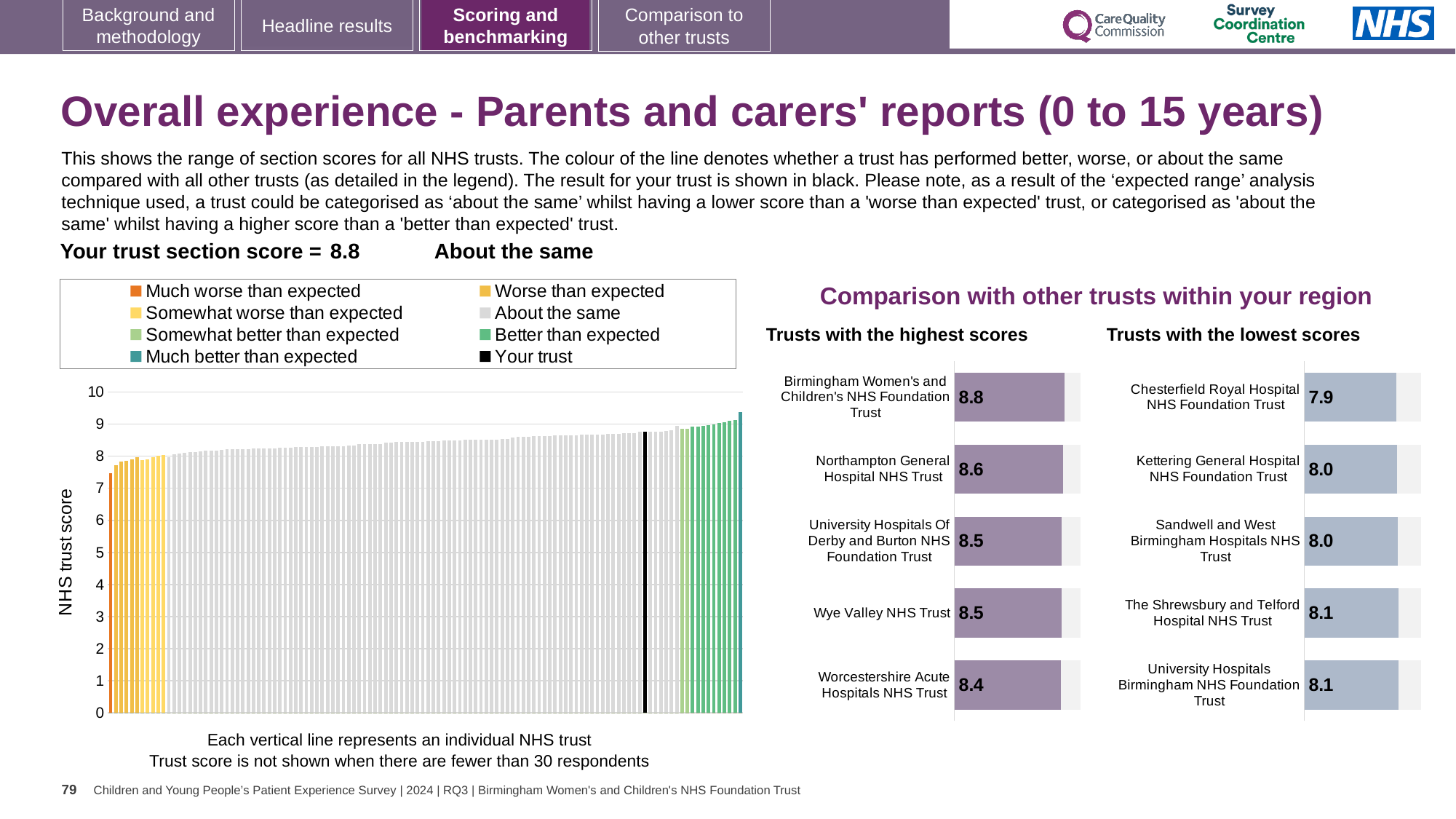
In the 'Trusts with the highest scores' chart, what is the score for Northampton General Hospital NHS Trust? 8.6 In the 'Trusts with the highest scores' chart, which trust has the highest score? Birmingham Women's and Children's NHS Foundation Trust In the main chart on the left showing all NHS trusts, is the value for the lowest (orange) bar greater or less than 8? less In the 'Trusts with the highest scores' chart, what is the difference between the scores of Birmingham Women's and Children's NHS Foundation Trust and Worcestershire Acute Hospitals NHS Trust? 0.4 In the 'Trusts with the highest scores' chart, what is the score for Worcestershire Acute Hospitals NHS Trust? 8.4 In the 'Trusts with the lowest scores' chart, what is the score for The Shrewsbury and Telford Hospital NHS Trust? 8.1 What kind of chart is the main chart on the left showing all NHS trusts? bar chart In the 'Trusts with the lowest scores' chart, what is the score for Chesterfield Royal Hospital NHS Foundation Trust? 7.9 How many entries does the legend of the main chart on the left list? 8 How many trusts are listed in the 'Trusts with the lowest scores' chart? 5 In the 'Trusts with the lowest scores' chart, which trust has the lowest score? Chesterfield Royal Hospital NHS Foundation Trust Which is larger: the score for Kettering General Hospital NHS Foundation Trust in the 'Trusts with the lowest scores' chart or the score for Wye Valley NHS Trust in the 'Trusts with the highest scores' chart? Wye Valley NHS Trust